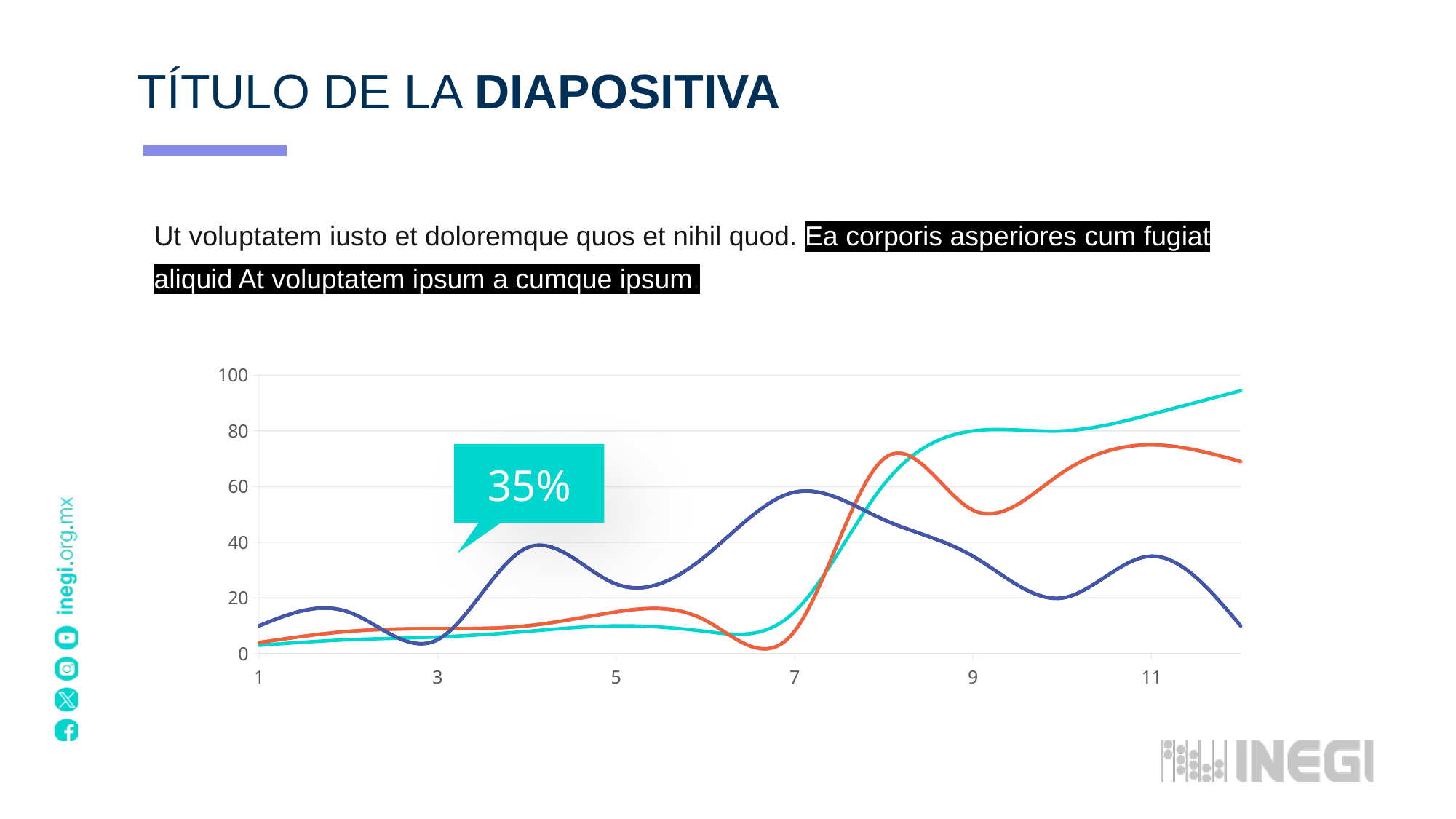
How many lines are plotted on the chart? 3 Is the value of the teal line at x = 12 greater or less than 80? greater What is the highest value shown on the vertical axis of the chart? 100 Does the teal line generally rise or fall from x = 1 to x = 12? rise Which line has the highest value at x = 12: the teal, orange or blue line? teal Is the value of the teal line at x = 5 greater or less than 20? less Is the value of the blue line at x = 7 greater or less than 40? greater Which line has the lowest value at x = 12: the teal, orange or blue line? blue What kind of chart is shown on the slide? line chart Which line has the highest value at x = 7: the teal, orange or blue line? blue What value is shown in the callout label on the chart? 35%